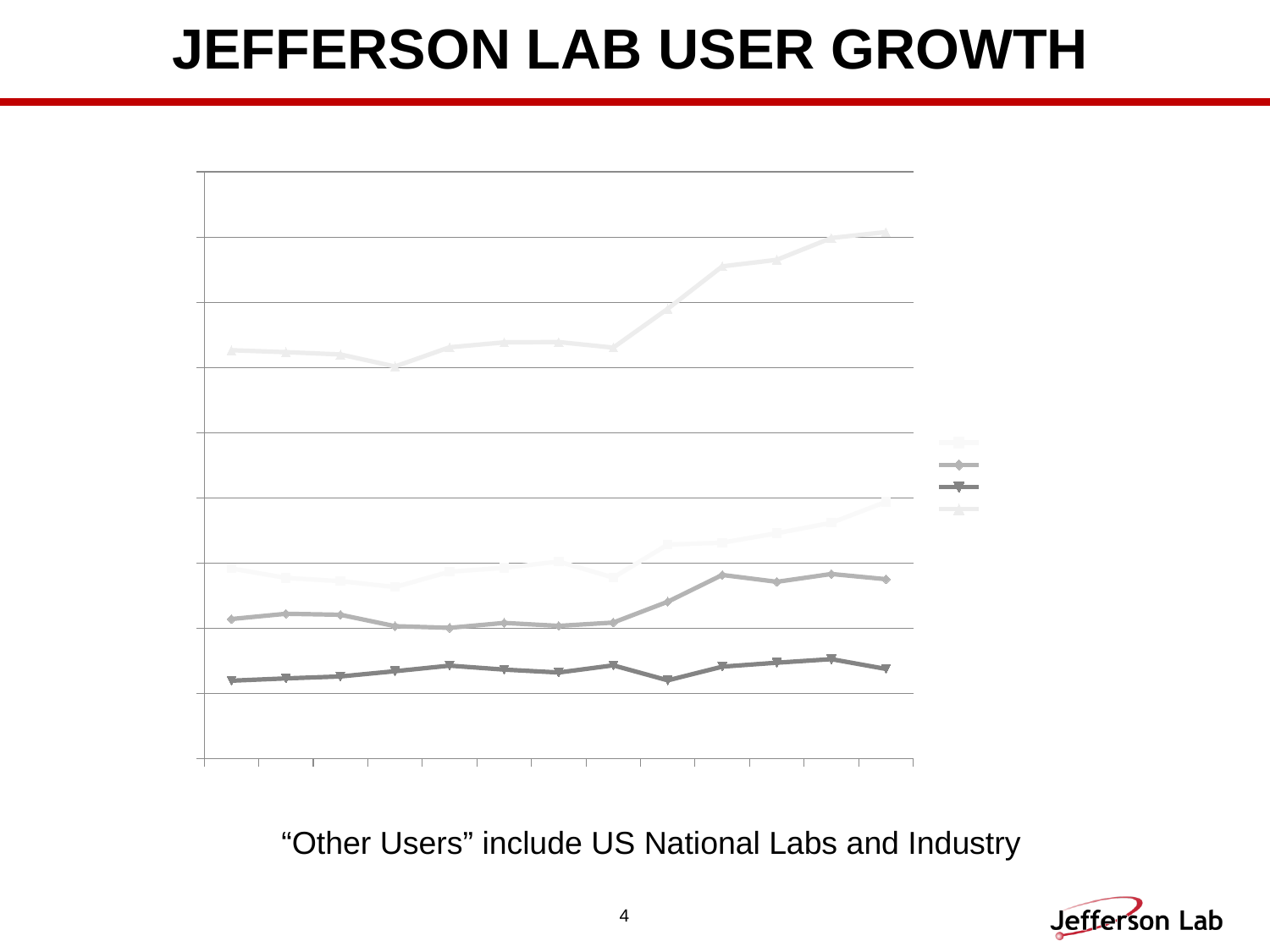
Does the second line from the top in the chart rise or fall overall from left to right? rises How many data points does each line in the chart have? 13 What is the title of the slide containing the chart? JEFFERSON LAB USER GROWTH According to the note below the chart, what do "Other Users" include? US National Labs and Industry What kind of chart is shown on the slide? line chart Does the topmost line in the chart rise or fall overall from left to right? rises How many series does the chart's legend list? 4